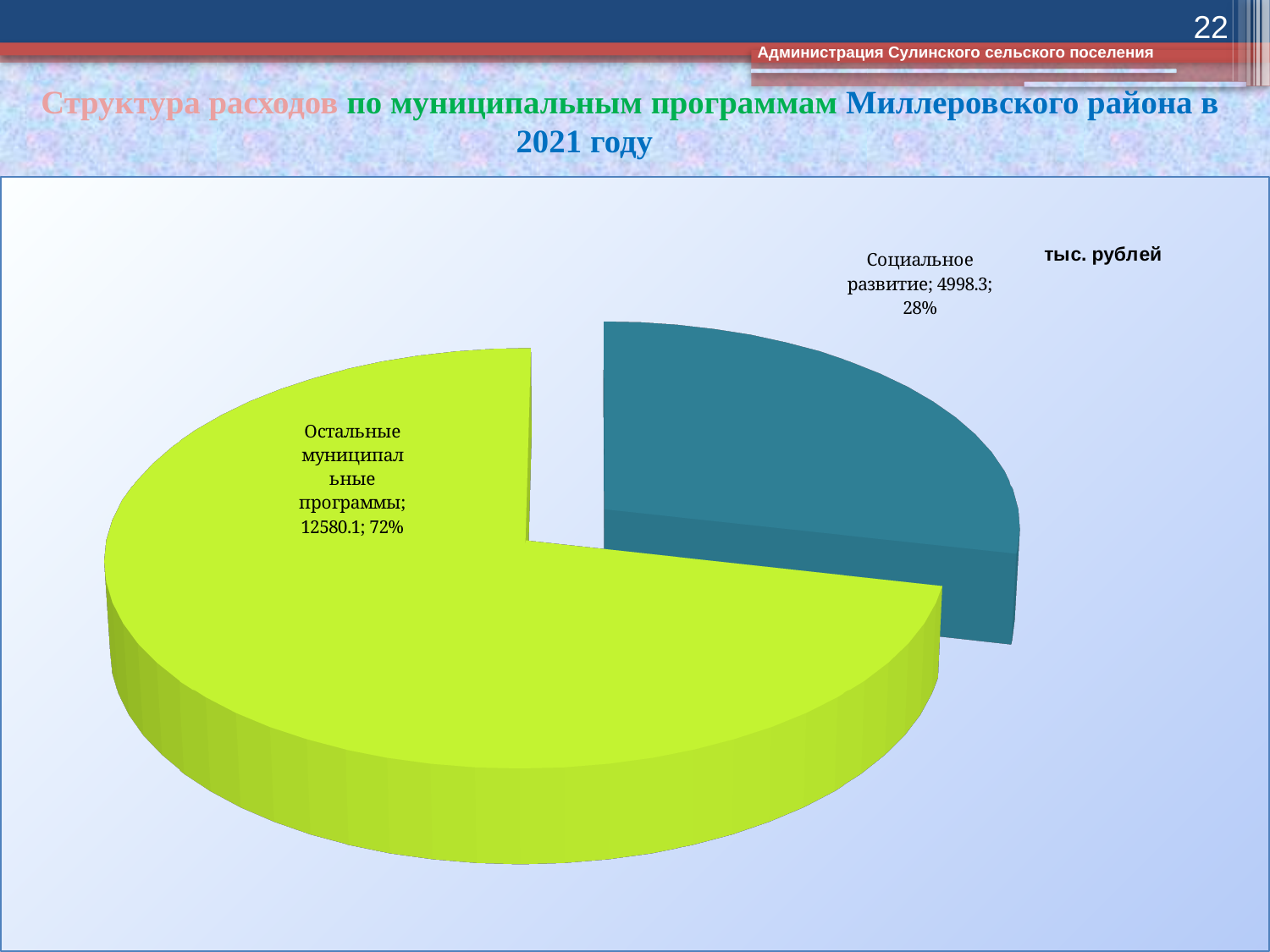
What is the difference between the values for Остальные муниципальные программы and Социальное развитие? 7581.8 What is the total of the two slices in the pie chart? 17578.4 Which slice is the smallest? Социальное развитие How many slices does the pie chart have? 2 What share of the pie does Социальное развитие represent? 28% What is the value for Остальные муниципальные программы? 12580.1 What unit is indicated for the values in the chart? тыс. рублей What is the value for Социальное развитие? 4998.3 Which slice is the largest? Остальные муниципальные программы What type of chart is shown on the slide? pie chart What share of the pie does Остальные муниципальные программы represent? 72% Which is larger: Социальное развитие or Остальные муниципальные программы? Остальные муниципальные программы